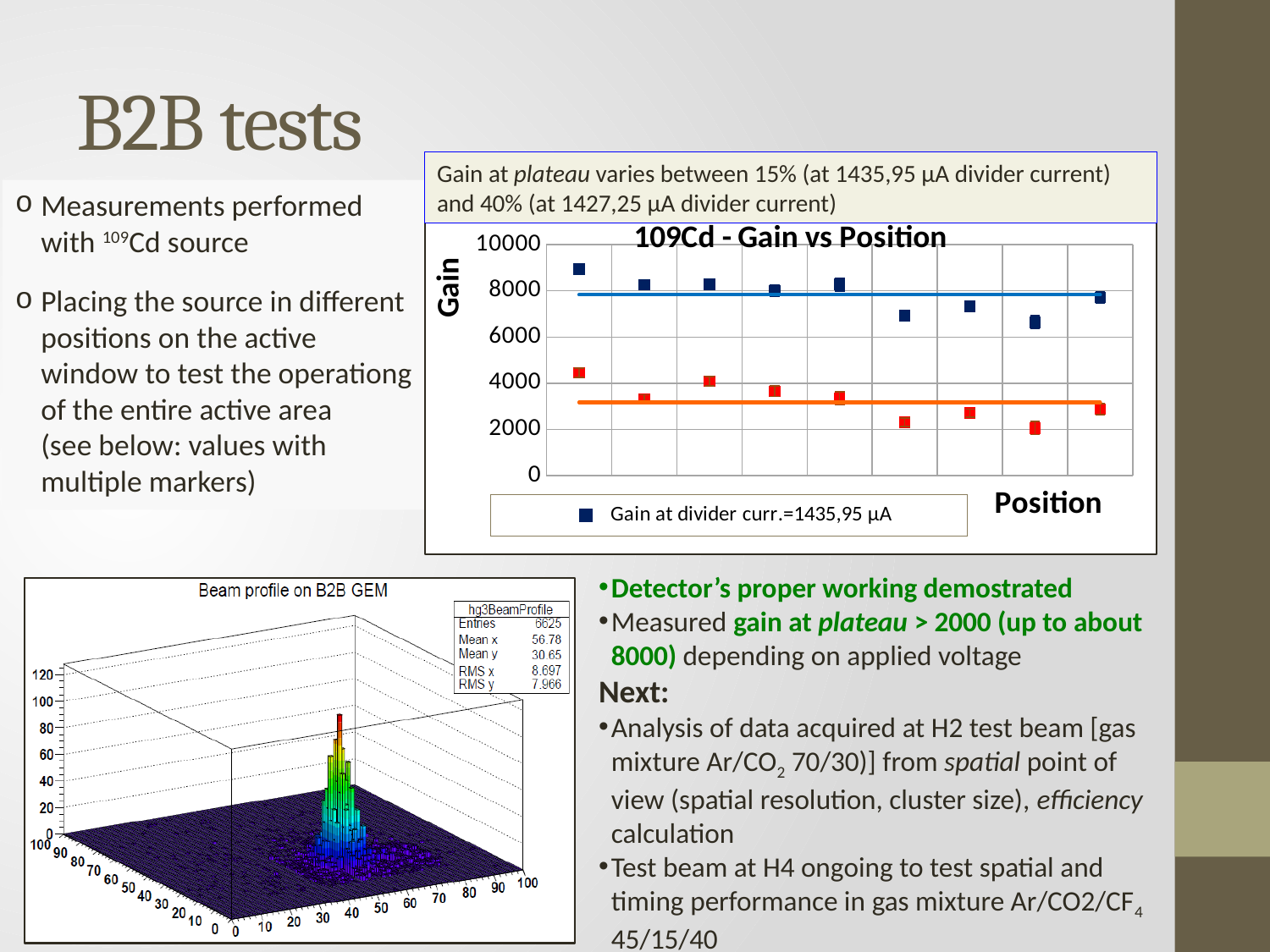
In the '109Cd - Gain vs Position' chart, is the first (leftmost) blue point greater or less than 8000? greater In the '109Cd - Gain vs Position' chart, do the blue gain values generally rise or fall from left to right along the position axis? fall What is the title of the chart in the upper right of the slide? 109Cd - Gain vs Position In the '109Cd - Gain vs Position' chart, are all the red points greater or less than 6000? less In the '109Cd - Gain vs Position' chart, what kind of chart is used to show the data? scatter chart In the '109Cd - Gain vs Position' chart, is the first (leftmost) red point greater or less than 4000? greater In the '109Cd - Gain vs Position' chart, how many data points does the blue series contain? 9 In the 'Beam profile on B2B GEM' plot, what is the number of Entries shown in the statistics box? 6625 In the '109Cd - Gain vs Position' chart, how many series of points are plotted? 2 In the '109Cd - Gain vs Position' chart, what is the label of the vertical axis? Gain In the '109Cd - Gain vs Position' chart, which series has the higher gain values, the blue series or the red series? the blue series